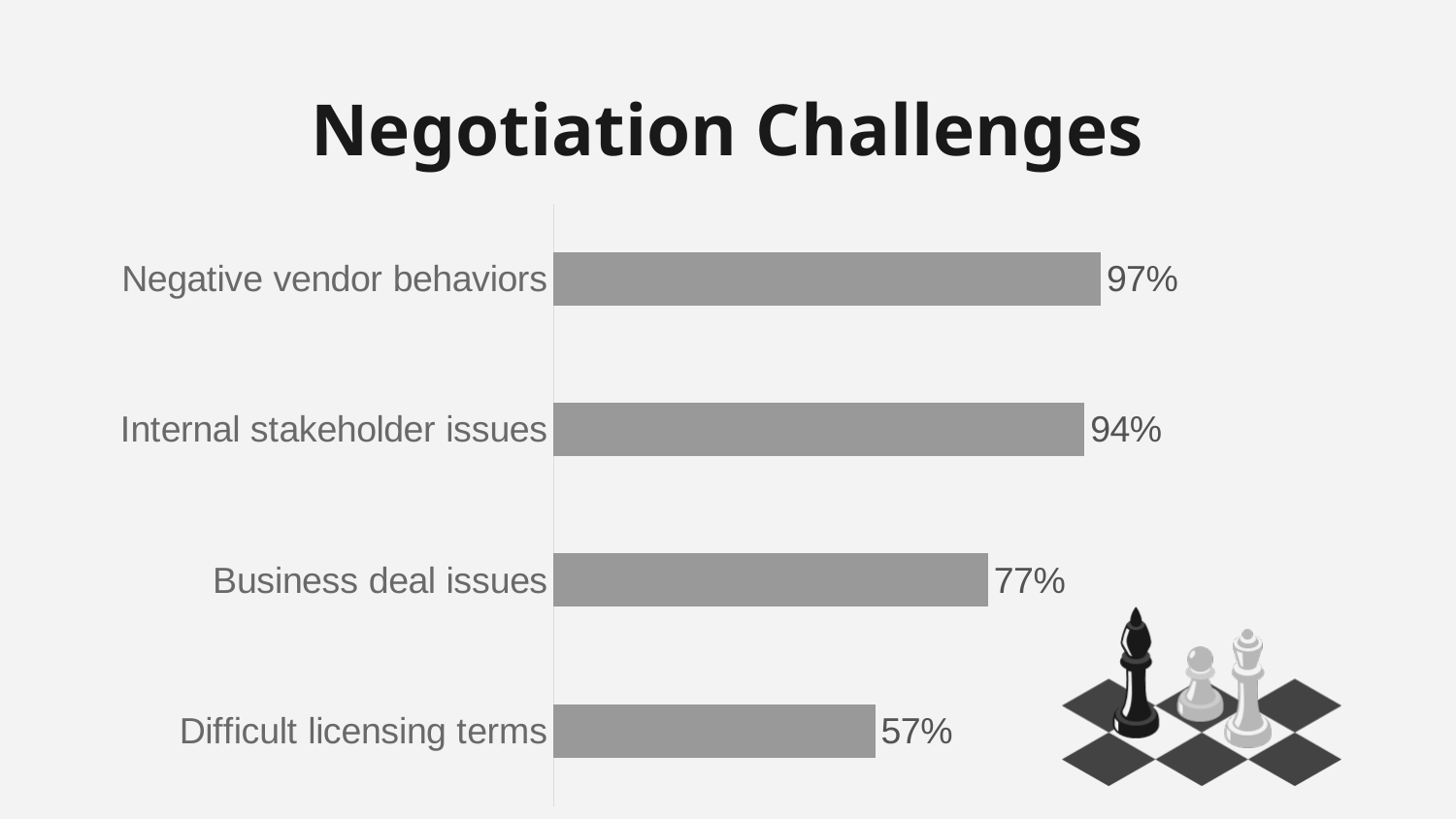
Which is larger, the value for Business deal issues or the value for Difficult licensing terms? Business deal issues What is the value for Internal stakeholder issues? 94% What is the difference between the values for Internal stakeholder issues and Business deal issues? 17% What kind of chart is shown on the slide? Bar chart How many categories are shown in the chart? 4 What is the title of the chart? Negotiation Challenges What is the difference between the values for Negative vendor behaviors and Difficult licensing terms? 40% What is the value for Negative vendor behaviors? 97% Which category has the lowest value? Difficult licensing terms Which category has the highest value? Negative vendor behaviors What is the value for Business deal issues? 77% What is the value for Difficult licensing terms? 57%